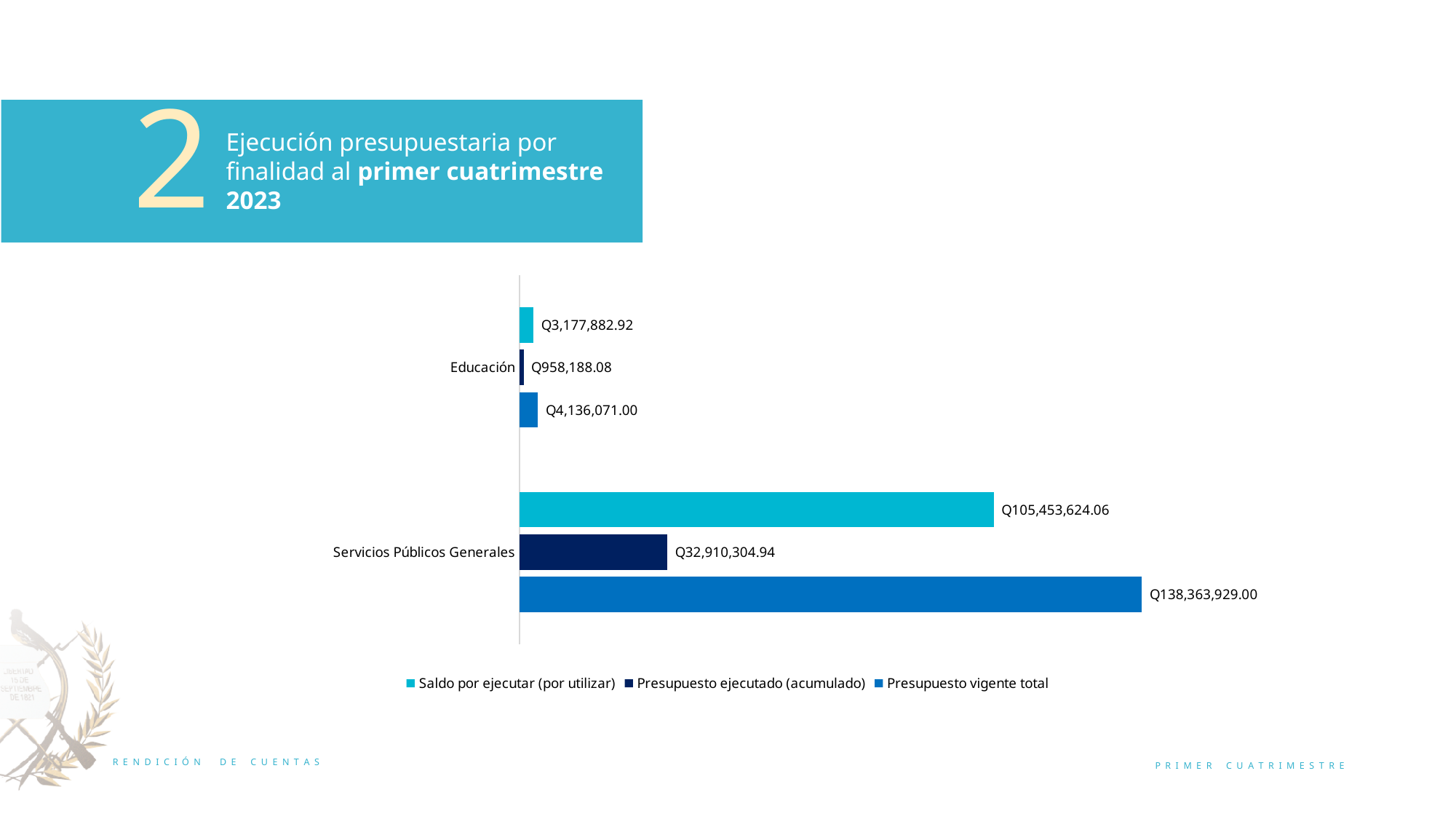
How many categories are shown on the chart? 2 What is the Presupuesto vigente total for Educación? Q4,136,071.00 What is the Presupuesto vigente total for Servicios Públicos Generales? Q138,363,929.00 What is the Saldo por ejecutar (por utilizar) for Servicios Públicos Generales? Q105,453,624.06 What is the Presupuesto ejecutado (acumulado) for Educación? Q958,188.08 What is the difference between the Presupuesto vigente total of Servicios Públicos Generales and that of Educación? Q134,227,858.00 What is the difference between the Presupuesto vigente total and the Presupuesto ejecutado (acumulado) for Servicios Públicos Generales? Q105,453,624.06 Which series is the smallest value for Educación? Presupuesto ejecutado (acumulado) Which category has the higher Presupuesto ejecutado (acumulado)? Servicios Públicos Generales What kind of chart is shown on the slide? Bar chart Which legend entry is shown in the darkest blue colour? Presupuesto ejecutado (acumulado) How many series does the legend list? 3